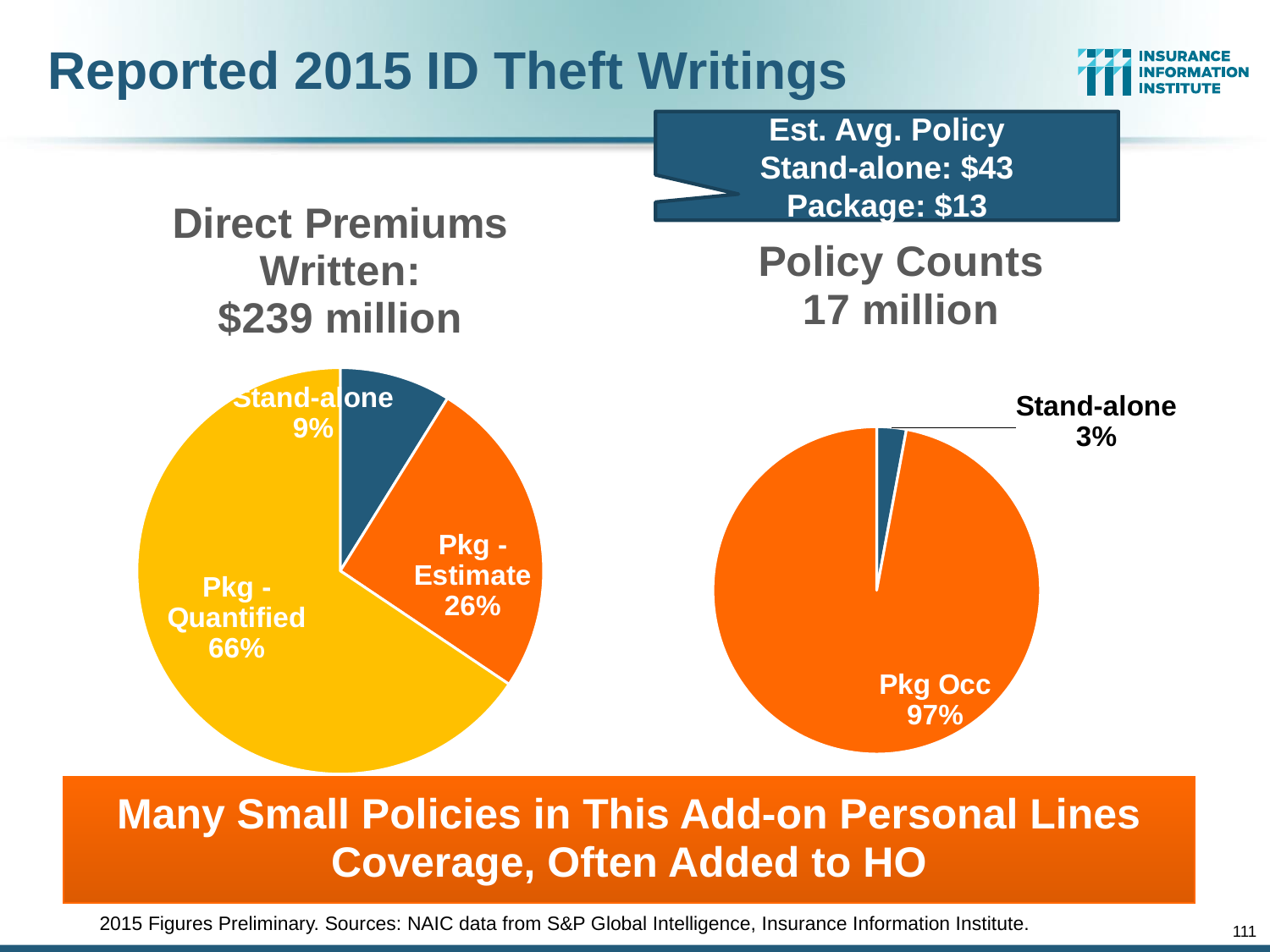
How many slices does the Direct Premiums Written pie chart have? 3 In the Direct Premiums Written pie chart, what share does Stand-alone have? 9% What type of chart is used for Policy Counts? Pie chart In the Direct Premiums Written pie chart, which slice is the smallest? Stand-alone In the Direct Premiums Written pie chart, how many percentage points larger is Pkg - Quantified than Pkg - Estimate? 40 In the Policy Counts pie chart, which slice is the largest? Pkg Occ In the Policy Counts pie chart, what share does Stand-alone have? 3% In the Direct Premiums Written pie chart, what share does Pkg - Quantified have? 66% In the Direct Premiums Written pie chart, which slice is the largest? Pkg - Quantified How many slices does the Policy Counts pie chart have? 2